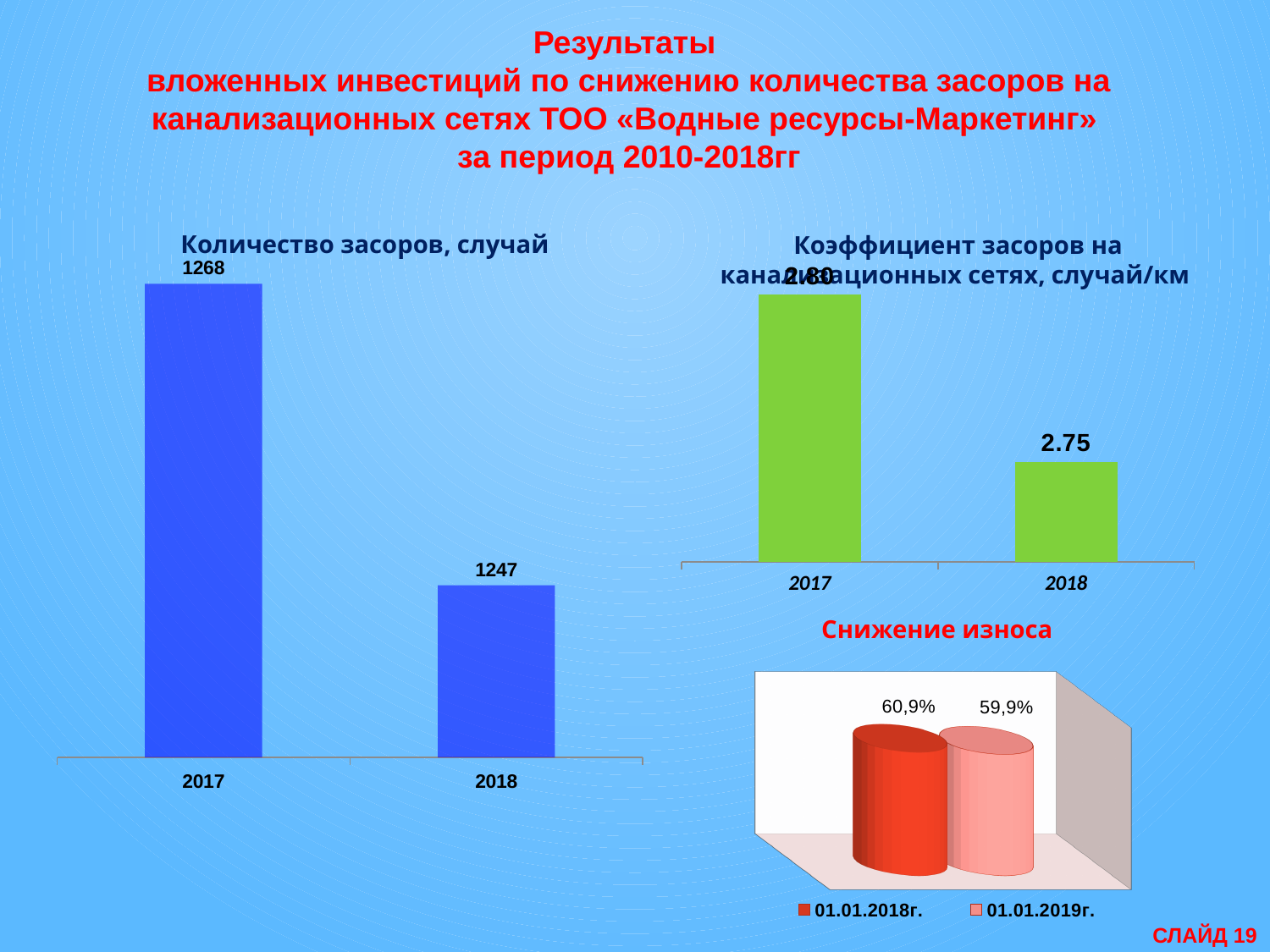
In the chart titled "Количество засоров, случай", what is the value for 2018? 1247 In the chart titled "Коэффициент засоров на канализационных сетях, случай/км", what is the value for 2018? 2.75 In the chart titled "Коэффициент засоров на канализационных сетях, случай/км", which year has the lower value? 2018 What kind of chart is the one titled "Коэффициент засоров на канализационных сетях, случай/км"? bar chart In the chart titled "Количество засоров, случай", what is the value for 2017? 1268 In the chart titled "Количество засоров, случай", do the values rise or fall from 2017 to 2018? fall In the chart titled "Количество засоров, случай", which year has the higher value? 2017 In the chart titled "Снижение износа", how many series does the legend list? 2 In the chart titled "Количество засоров, случай", how many bars are plotted? 2 In the chart titled "Снижение износа", what is the value for 01.01.2018г.? 60,9% In the chart titled "Снижение износа", what is the value for 01.01.2019г.? 59,9% In the chart titled "Количество засоров, случай", what is the difference between the 2017 and 2018 values? 21